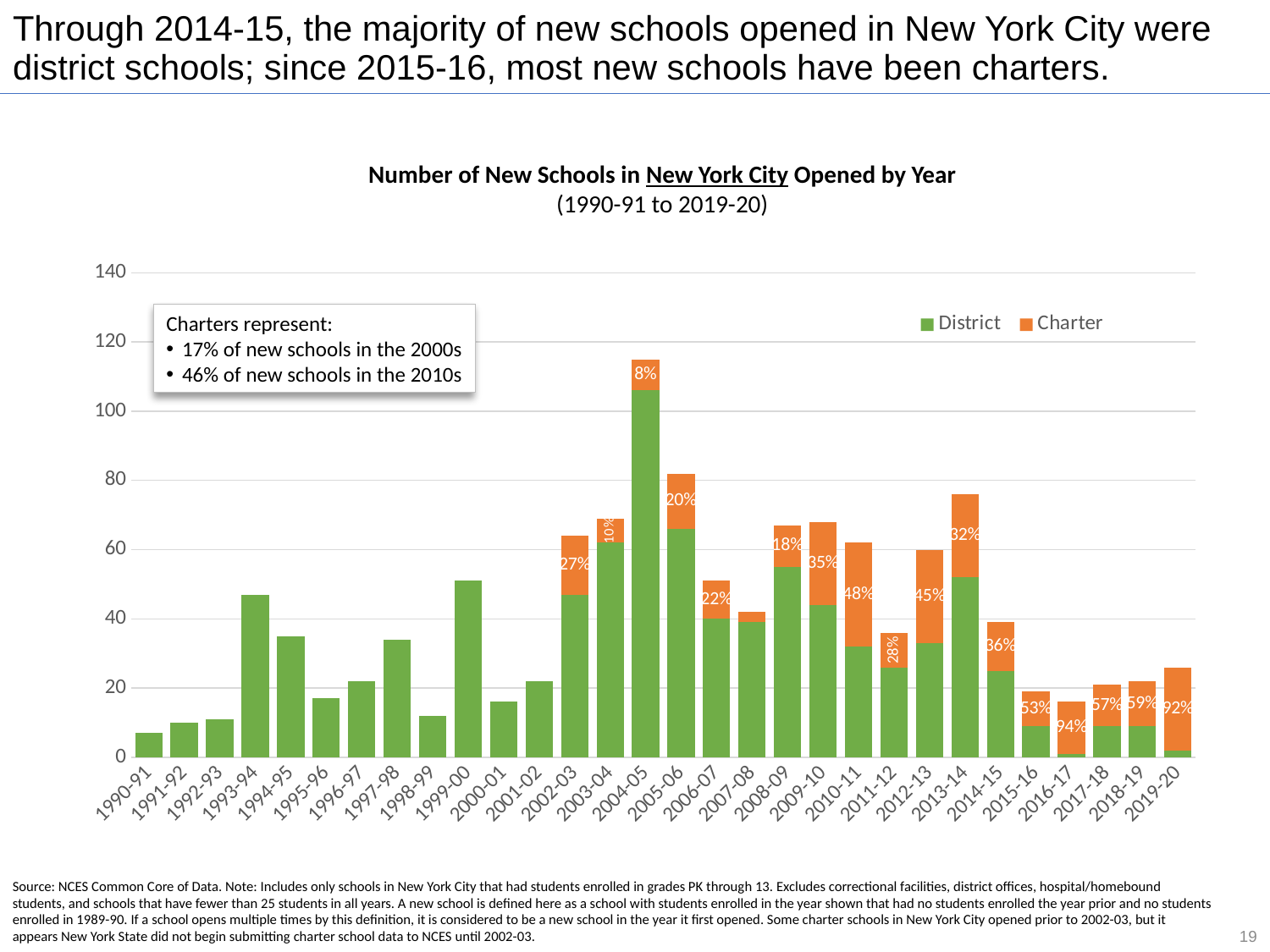
What are the two series named in the legend? District and Charter Is the total number of new schools in 2013-14 greater or less than 60? greater Which school year has the shortest bar (fewest new schools opened)? 1990-91 What percentage label is shown on the 2010-11 bar? 48% How many school years are shown along the x axis? 30 Which year had more new schools opened in total, 1993-94 or 1994-95? 1993-94 What percentage label is shown on the 2004-05 bar? 8% Which school year has the tallest bar (most new schools opened)? 2004-05 How many series does the legend list? 2 What type of chart is shown on the slide? Stacked bar chart Is the total number of new schools in 2004-05 greater or less than 100? greater What percentage of new schools were charters in 2016-17, according to the data label? 94%